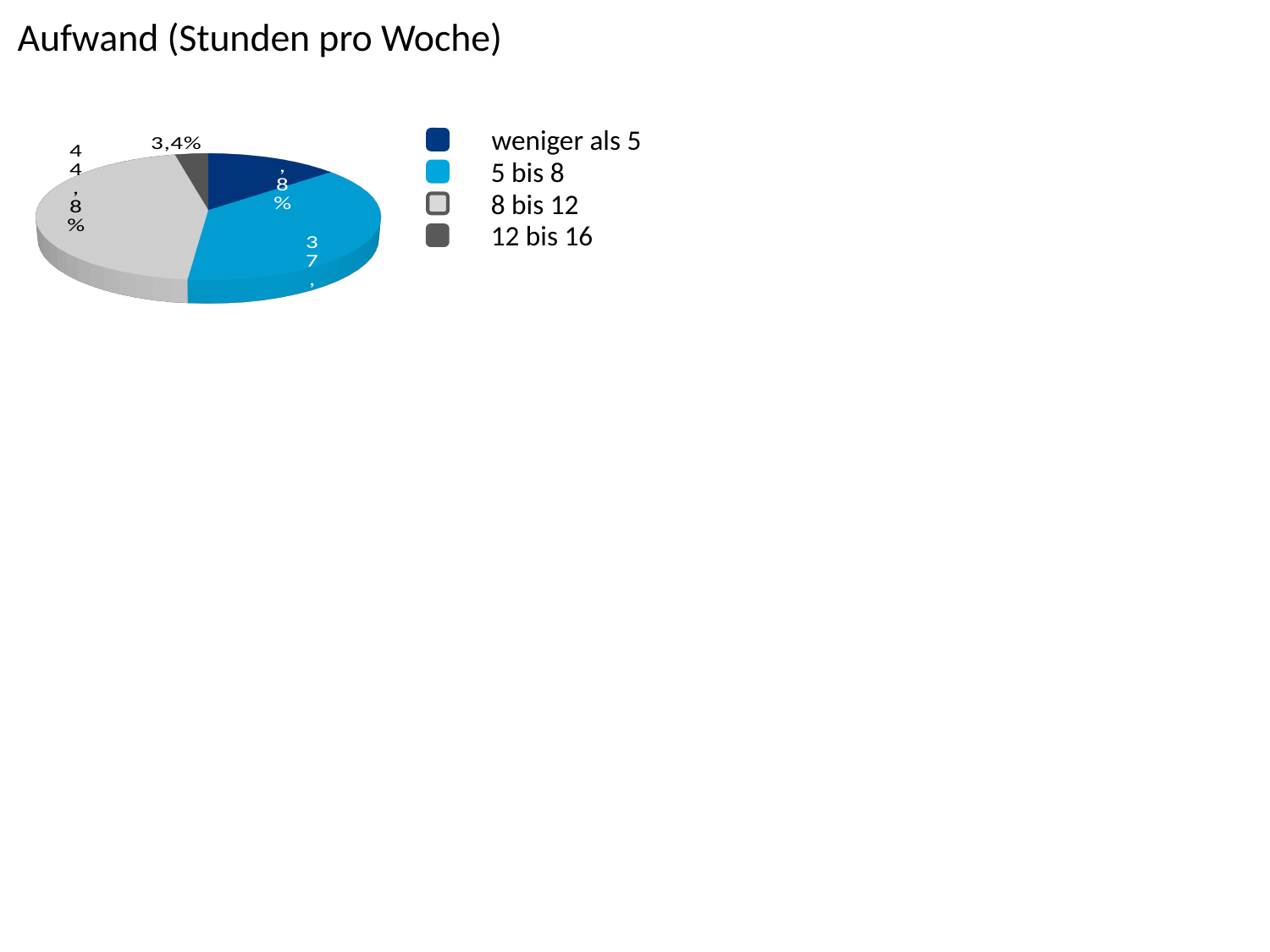
Which category has the largest share of the pie? 8 bis 12 Which category has the smallest share of the pie? 12 bis 16 What percentage is shown for the "8 bis 12" slice? 44,8% What percentage is shown for the "12 bis 16" slice? 3,4% Which legend entry is shown in light grey? 8 bis 12 How many entries does the legend list? 4 What kind of chart is shown on the slide? pie chart What is the difference in percentage points between the "8 bis 12" slice and the "12 bis 16" slice? 41,4% How many slices does the pie chart have? 4 Which slice is larger, "5 bis 8" or "weniger als 5"? 5 bis 8 What is the title of the chart? Aufwand (Stunden pro Woche)